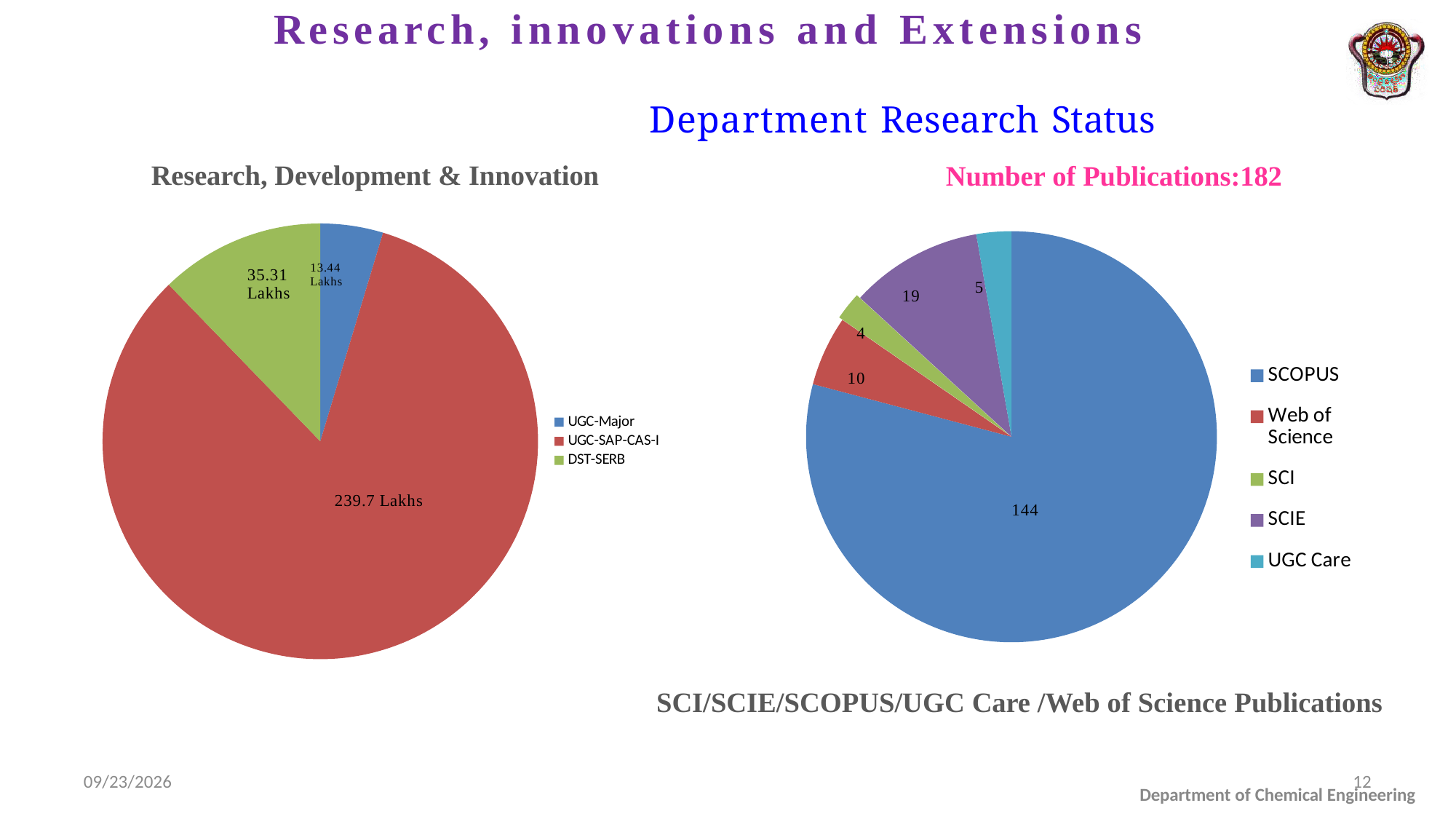
In the 'Research, Development & Innovation' chart, what is the difference between the DST-SERB and UGC-Major values? 21.87 Lakhs In the 'Number of Publications:182' chart, how many publications are in SCOPUS? 144 In the 'Number of Publications:182' chart, how many publications are in SCIE? 19 In the 'Number of Publications:182' chart, what colour is the SCOPUS slice? Blue In the 'Research, Development & Innovation' chart, what is the value for UGC-SAP-CAS-I? 239.7 Lakhs In the 'Research, Development & Innovation' chart, which category has the smallest slice? UGC-Major How many categories does the legend of the 'Number of Publications:182' chart list? 5 In the 'Number of Publications:182' chart, which category has the fewest publications? SCI In the 'Number of Publications:182' chart, which is larger, Web of Science or SCIE? SCIE In the 'Number of Publications:182' chart, what is the difference between SCOPUS and SCIE? 125 What kind of chart is the 'Research, Development & Innovation' chart? Pie chart In the 'Research, Development & Innovation' chart, what is the value for DST-SERB? 35.31 Lakhs